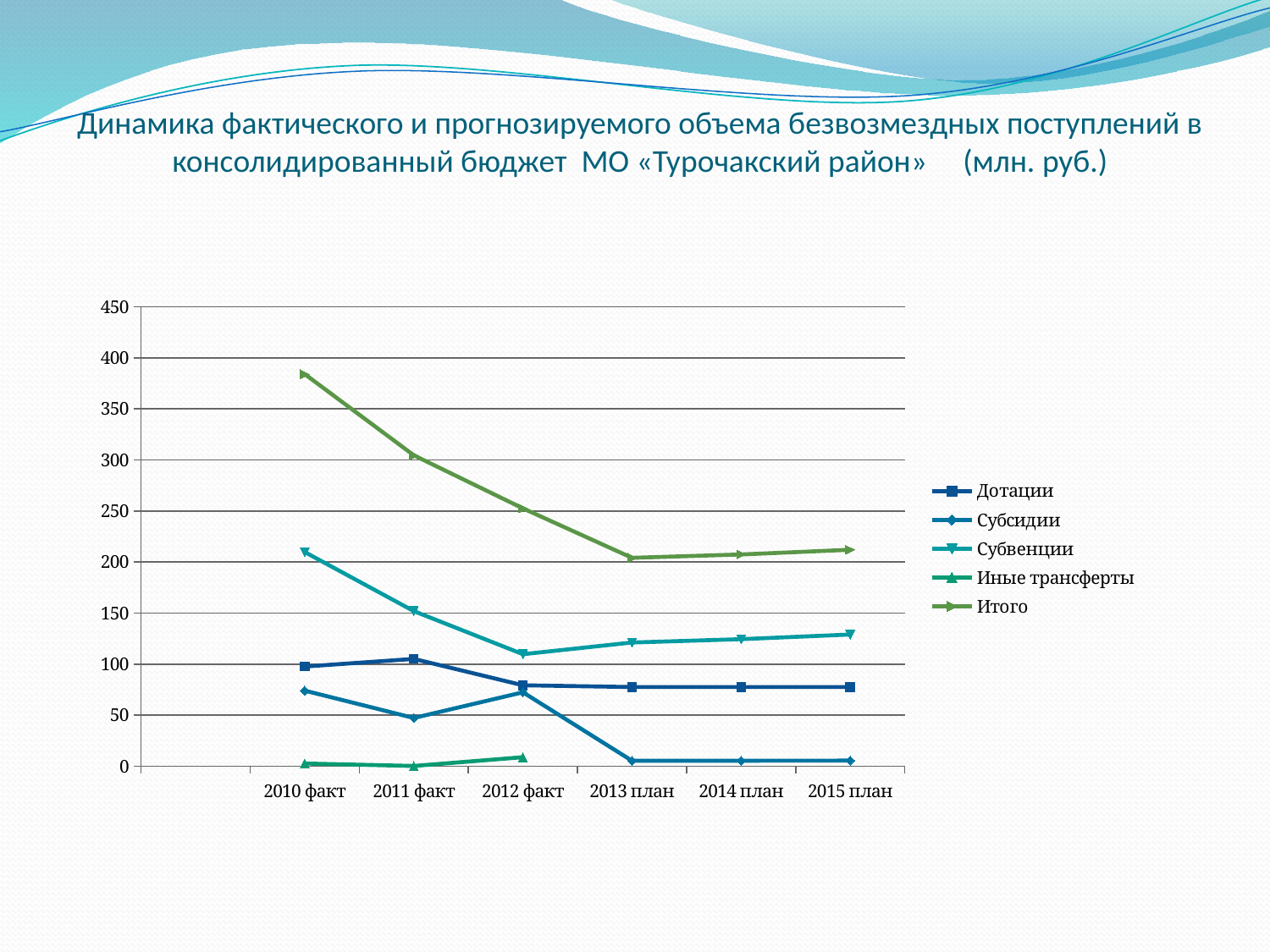
In which category does the Итого series reach its highest value? 2010 факт Which series is listed last in the legend? Итого Which is larger in 2010 факт, Субвенции or Дотации? Субвенции Does the Итого series rise or fall from 2010 факт to 2013 план? fall Is the value for Итого in 2010 факт greater or less than 350? greater Is the value for Субвенции in 2011 факт greater or less than 200? less Which series has the highest value in 2010 факт? Итого How many series does the legend list? 5 What kind of chart is shown on the slide? line chart Which series has the lowest value in 2011 факт? Иные трансферты Is the value for Субсидии in 2013 план greater or less than 50? less How many categories are shown on the x axis? 6